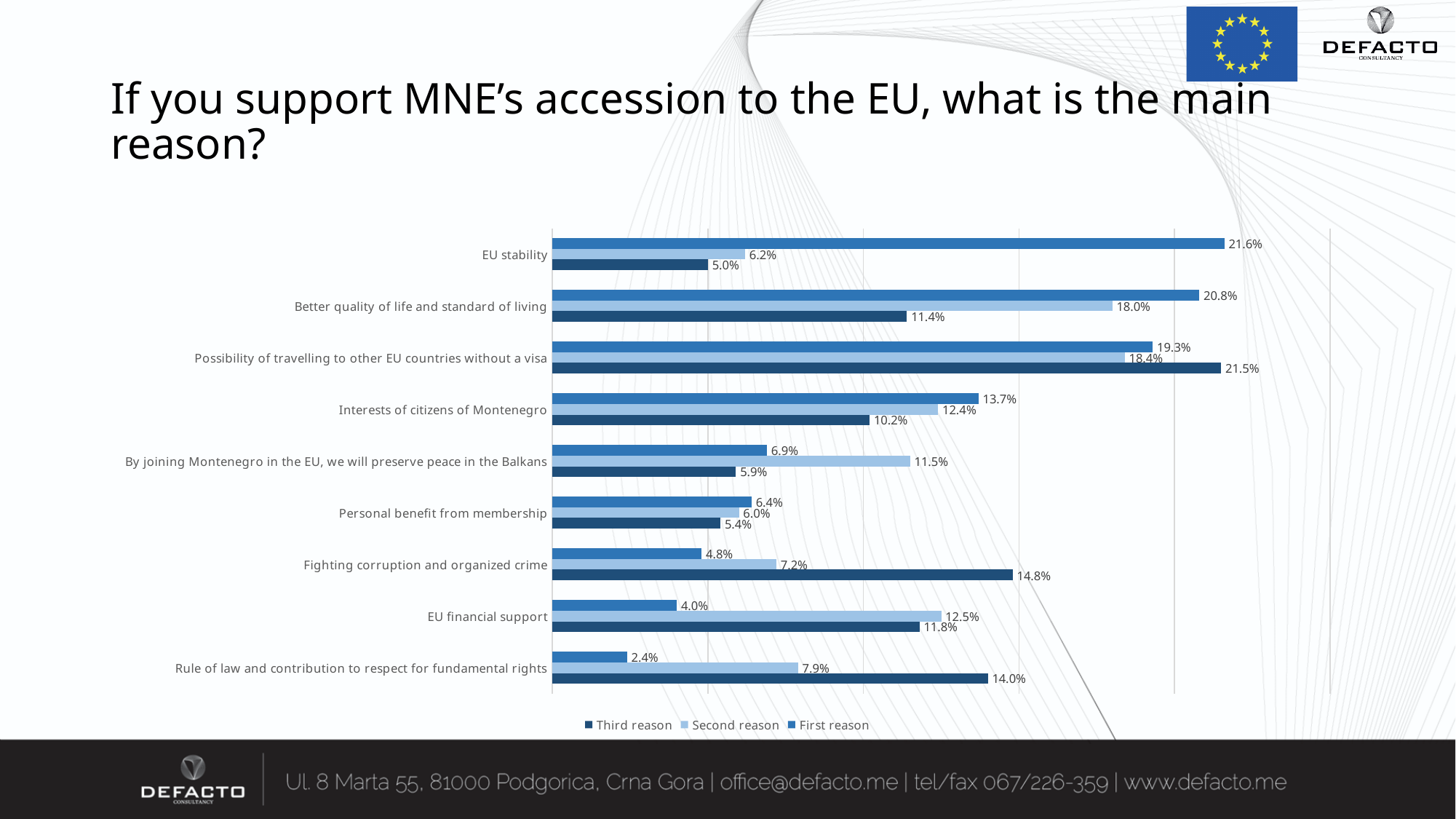
What is the Second reason value for EU financial support? 12.5% What is the difference between the First reason and Third reason values for EU stability? 16.6% What type of chart is shown on the slide? Bar chart Which category has the highest First reason value? EU stability What is the Third reason value for Fighting corruption and organized crime? 14.8% Which category has the lowest First reason value? Rule of law and contribution to respect for fundamental rights Which category has the highest Third reason value? Possibility of travelling to other EU countries without a visa How many series does the legend list? 3 What is the First reason value for EU stability? 21.6% What are the three series listed in the legend? Third reason, Second reason, First reason How many categories (reasons) are shown in the chart? 9 Which is larger for Better quality of life and standard of living: the First reason value or the Second reason value? First reason